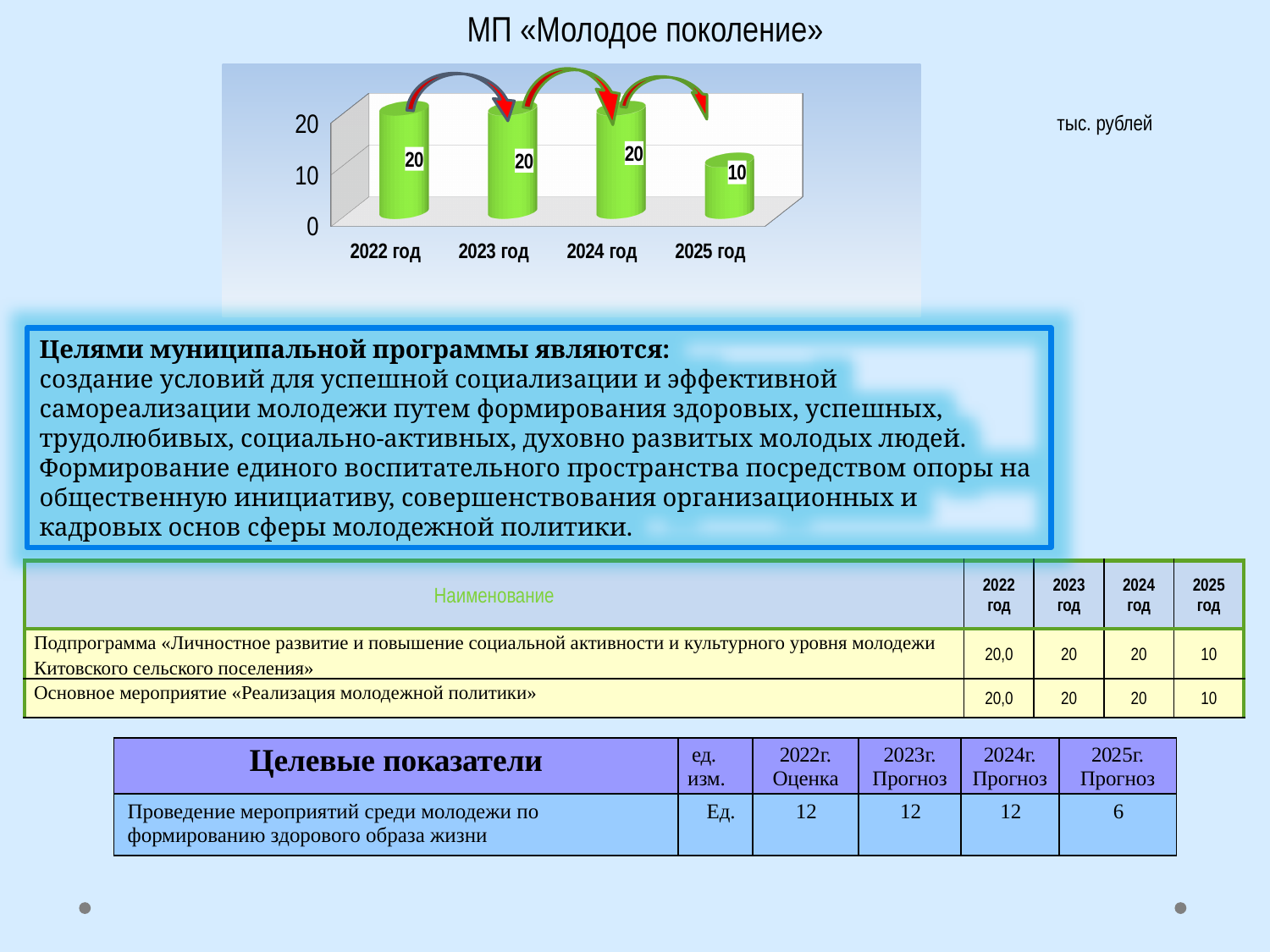
How many categories (years) are shown on the chart? 4 What unit of measurement is indicated next to the chart? тыс. рублей Which is larger, the value for 2023 год or the value for 2025 год? 2023 год Is the value for 2025 год greater or less than 20? less What is the value for 2025 год on the chart? 10 Do the values on the chart rise or fall from 2024 год to 2025 год? fall Which year has the lowest value on the chart? 2025 год What is the highest value shown on the chart's vertical axis? 20 What kind of chart is shown on the slide? bar chart What is the value for 2024 год on the chart? 20 What is the value for 2022 год on the chart? 20 What is the difference between the values for 2024 год and 2025 год? 10